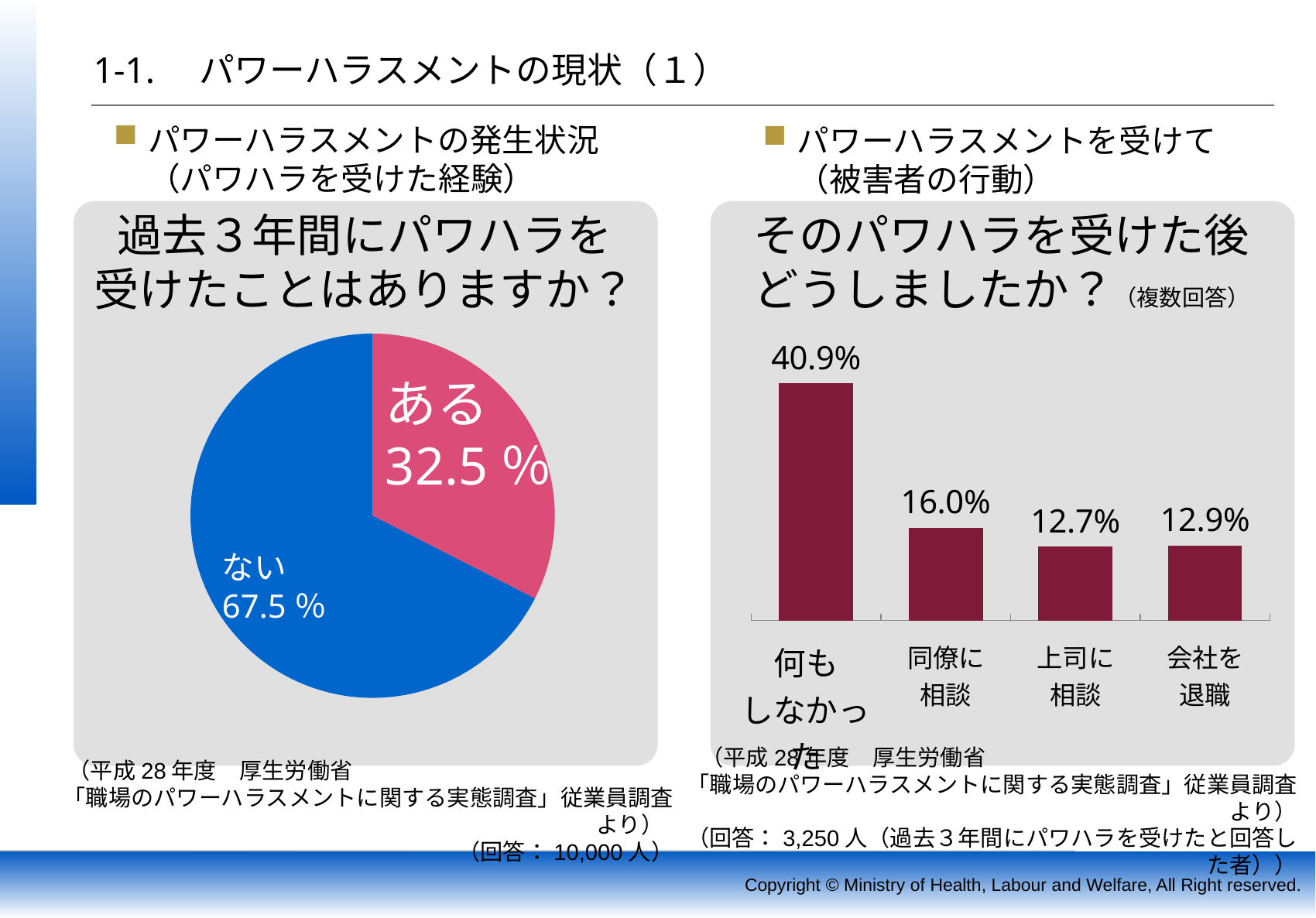
In the bar chart on the right, how many categories are plotted? 4 In the pie chart on the left, which slice is larger, ある or ない? ない In the pie chart on the left, what is the difference in percentage points between ない and ある? 35 percentage points In the bar chart on the right, which category has the highest value? 何もしなかった In the pie chart on the left, what percentage of respondents answered ある (yes, experienced power harassment)? 32.5 % In the bar chart on the right, what is the value for 何もしなかった (did nothing)? 40.9% In the pie chart on the left, what percentage of respondents answered ない (no)? 67.5 % What type of chart is shown on the left side of the slide? Pie chart In the bar chart on the right, which category has the lowest value? 上司に相談 In the bar chart on the right, what is the value for 同僚に相談 (consulted a colleague)? 16.0% In the bar chart on the right, what is the difference between 何もしなかった and 同僚に相談? 24.9 percentage points What type of chart is shown on the right side of the slide? Bar chart